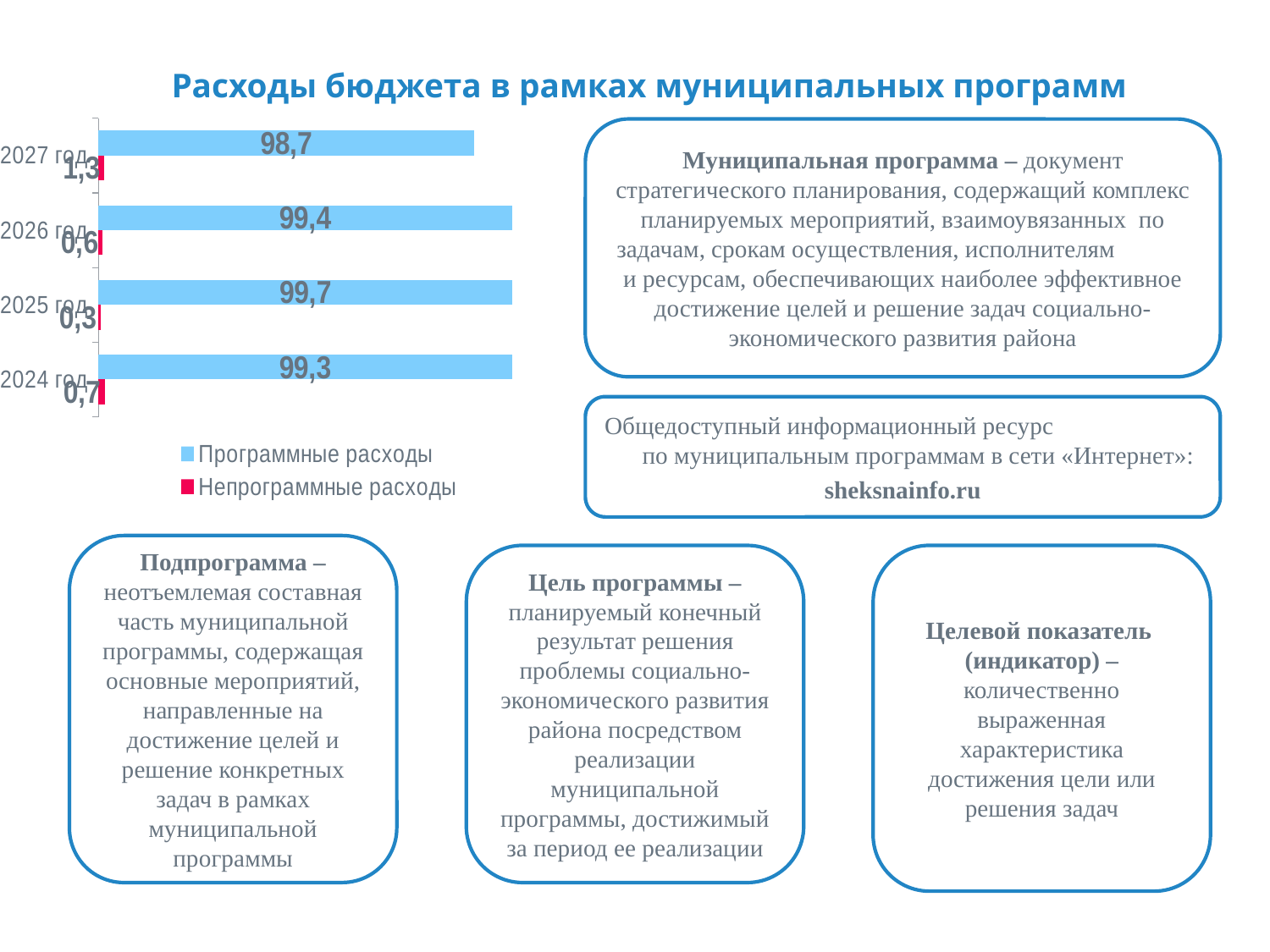
How many series does the legend list? 2 What is the total of Программные расходы and Непрограммные расходы for 2026 год? 100,0 What is the value of Программные расходы for 2025 год? 99,7 What is the value of Непрограммные расходы for 2024 год? 0,7 How many years are shown on the chart? 4 What is the value of Программные расходы for 2027 год? 98,7 Which is larger: Непрограммные расходы for 2024 год or for 2025 год? 2024 год Which year has the highest value of Непрограммные расходы? 2027 год What is the difference between Программные расходы for 2025 год and 2027 год? 1,0 What is the value of Непрограммные расходы for 2026 год? 0,6 What type of chart is shown on the slide? Bar chart Which year has the lowest value of Программные расходы? 2027 год